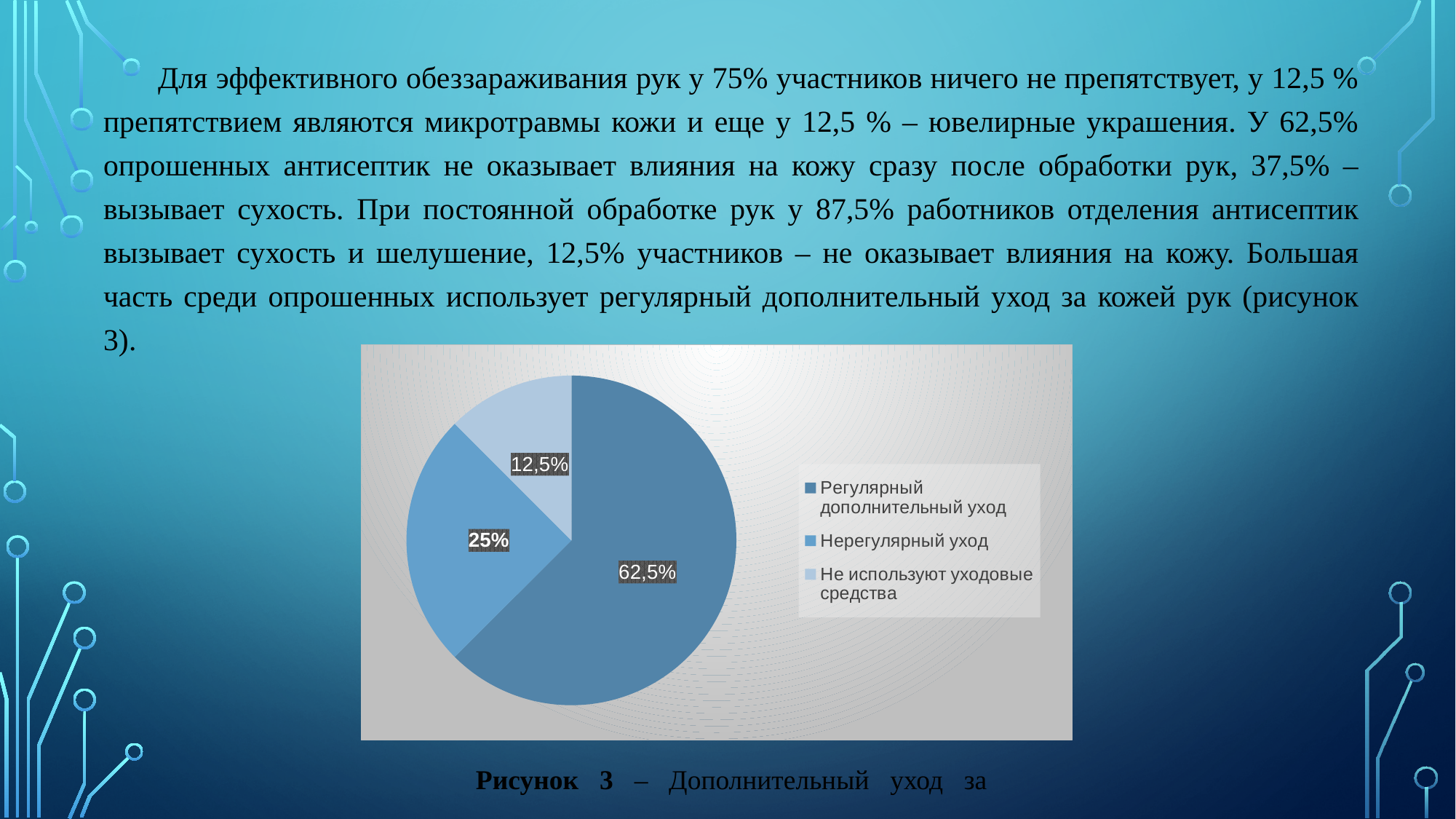
What share of the pie corresponds to "Нерегулярный уход"? 25% Which is larger: the slice for "Нерегулярный уход" or the slice for "Не используют уходовые средства"? Нерегулярный уход What share of the pie corresponds to "Регулярный дополнительный уход"? 62,5% What is the difference in percentage points between "Нерегулярный уход" and "Не используют уходовые средства"? 12,5 Which category has the largest slice of the pie? Регулярный дополнительный уход What is the difference in percentage points between "Регулярный дополнительный уход" and "Нерегулярный уход"? 37,5 How many entries does the legend of the pie chart list? 3 What type of chart is shown on the slide? Pie chart Which legend entry is shown in the lightest blue colour? Не используют уходовые средства What share of the pie corresponds to "Не используют уходовые средства"? 12,5% Which category has the smallest slice of the pie? Не используют уходовые средства How many slices does the pie chart have? 3